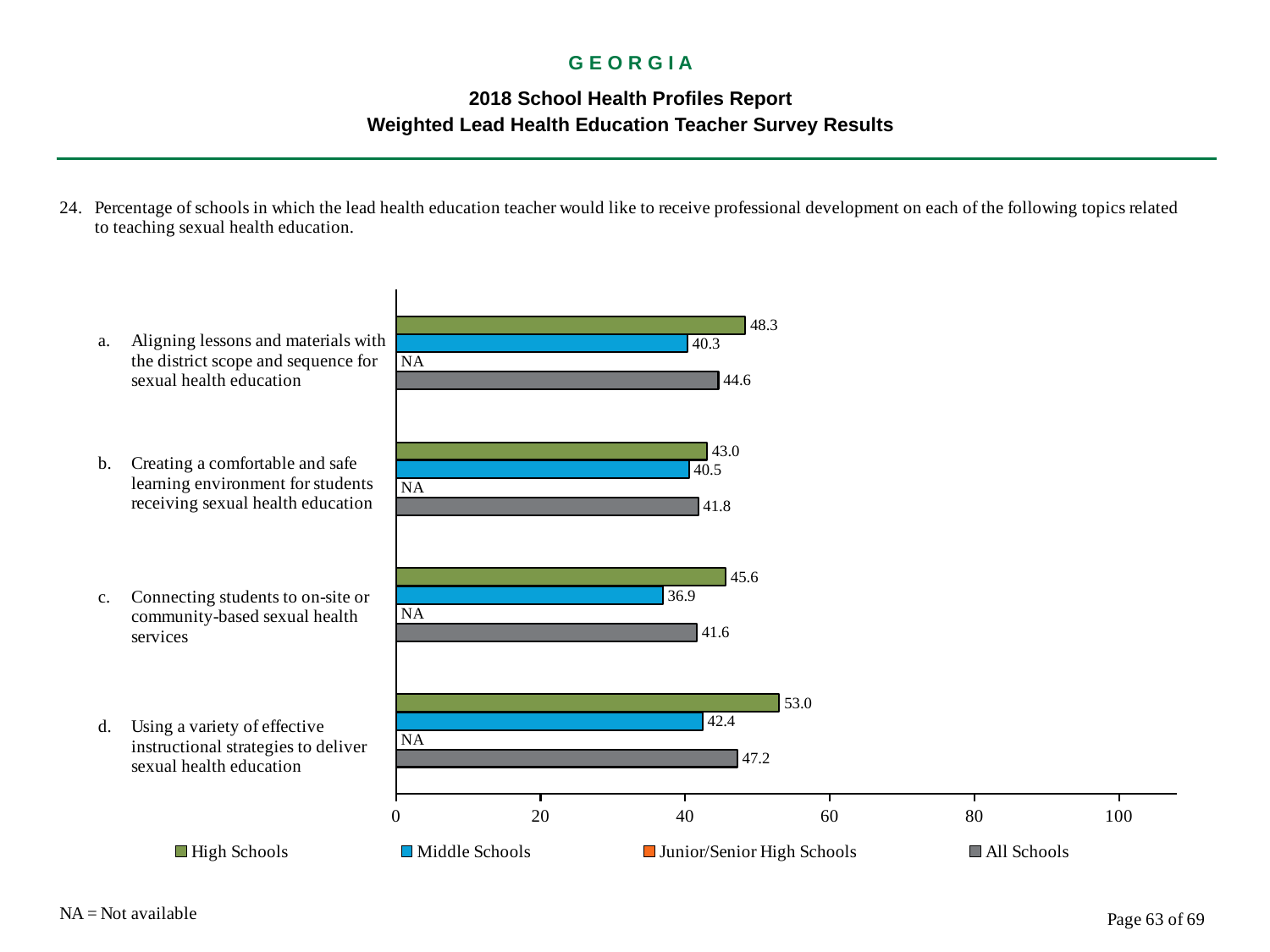
What is the High Schools value for 'Using a variety of effective instructional strategies to deliver sexual health education'? 53.0 Which topic has the highest High Schools value? Using a variety of effective instructional strategies to deliver sexual health education What is the All Schools value for 'Aligning lessons and materials with the district scope and sequence for sexual health education'? 44.6 Which topic has the lowest Middle Schools value? Connecting students to on-site or community-based sexual health services Is the High Schools value for 'Using a variety of effective instructional strategies to deliver sexual health education' greater or less than 40? greater What kind of chart is shown on the slide? Bar chart What value is shown for the Junior/Senior High Schools series for each topic? NA How many topics (categories) are shown on the chart? 4 Which is larger: the All Schools value for 'Using a variety of effective instructional strategies' or the All Schools value for 'Creating a comfortable and safe learning environment'? Using a variety of effective instructional strategies How many series does the legend list? 4 What is the Middle Schools value for 'Connecting students to on-site or community-based sexual health services'? 36.9 What is the difference between the High Schools and Middle Schools values for 'Creating a comfortable and safe learning environment for students receiving sexual health education'? 2.5